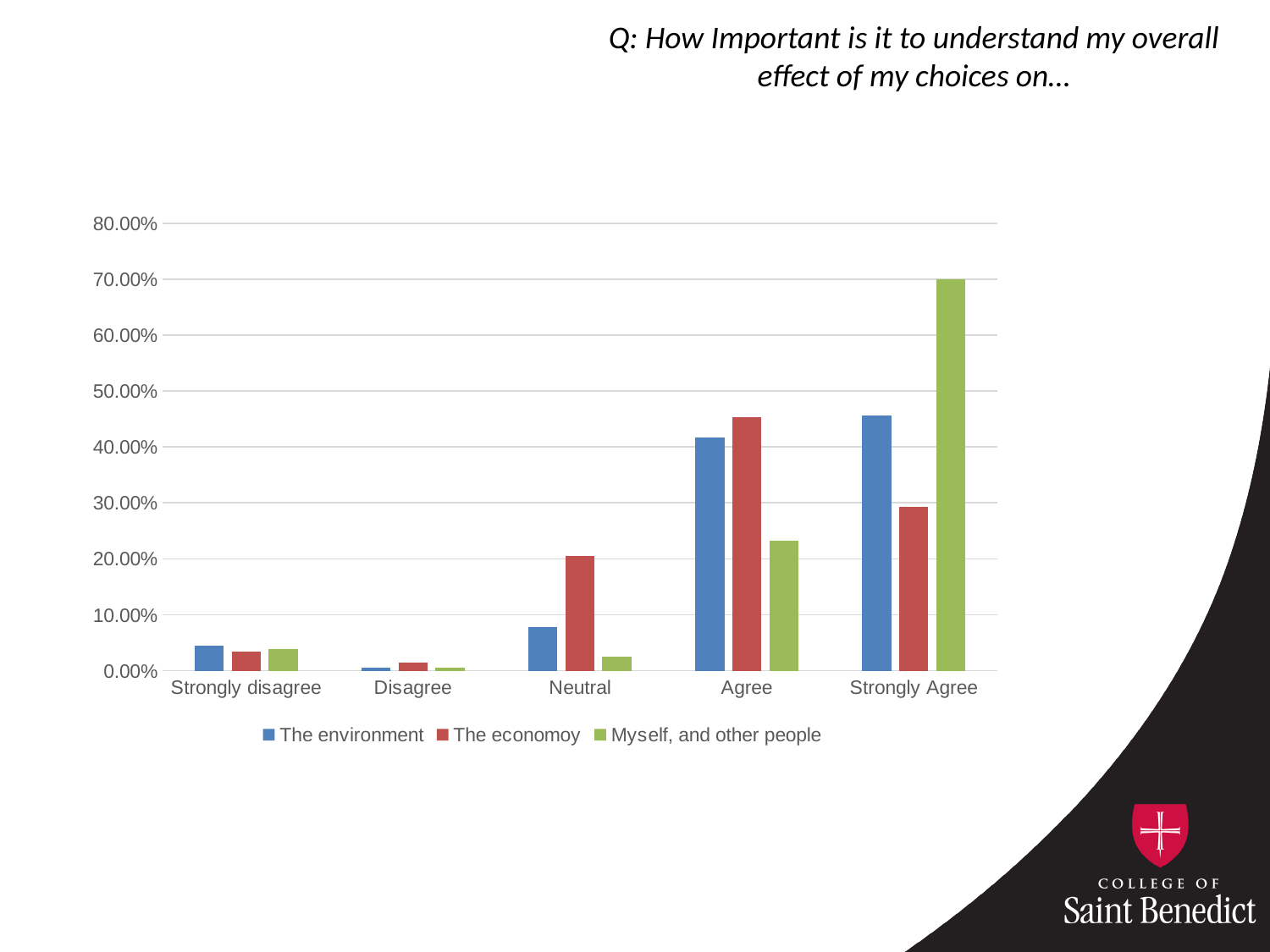
For the series "Myself, and other people", which category has the highest value? Strongly Agree In the Agree category, which is larger: "The environment" or "The economoy"? The economoy Is the value for "The environment" at Strongly Agree greater or less than 40%? greater How many response categories are shown on the x axis? 5 Which series is shown in green in the legend? Myself, and other people For the series "The economoy", which category has the highest value? Agree How many series does the legend list? 3 In the Strongly Agree category, which is larger: "The environment" or "The economoy"? The environment Is the value for "Myself, and other people" at Strongly Agree greater or less than 60%? greater Is the value for "The economoy" at Neutral greater or less than 10%? greater What kind of chart is shown on the slide? Bar chart For the series "The environment", which category has the lowest value? Disagree